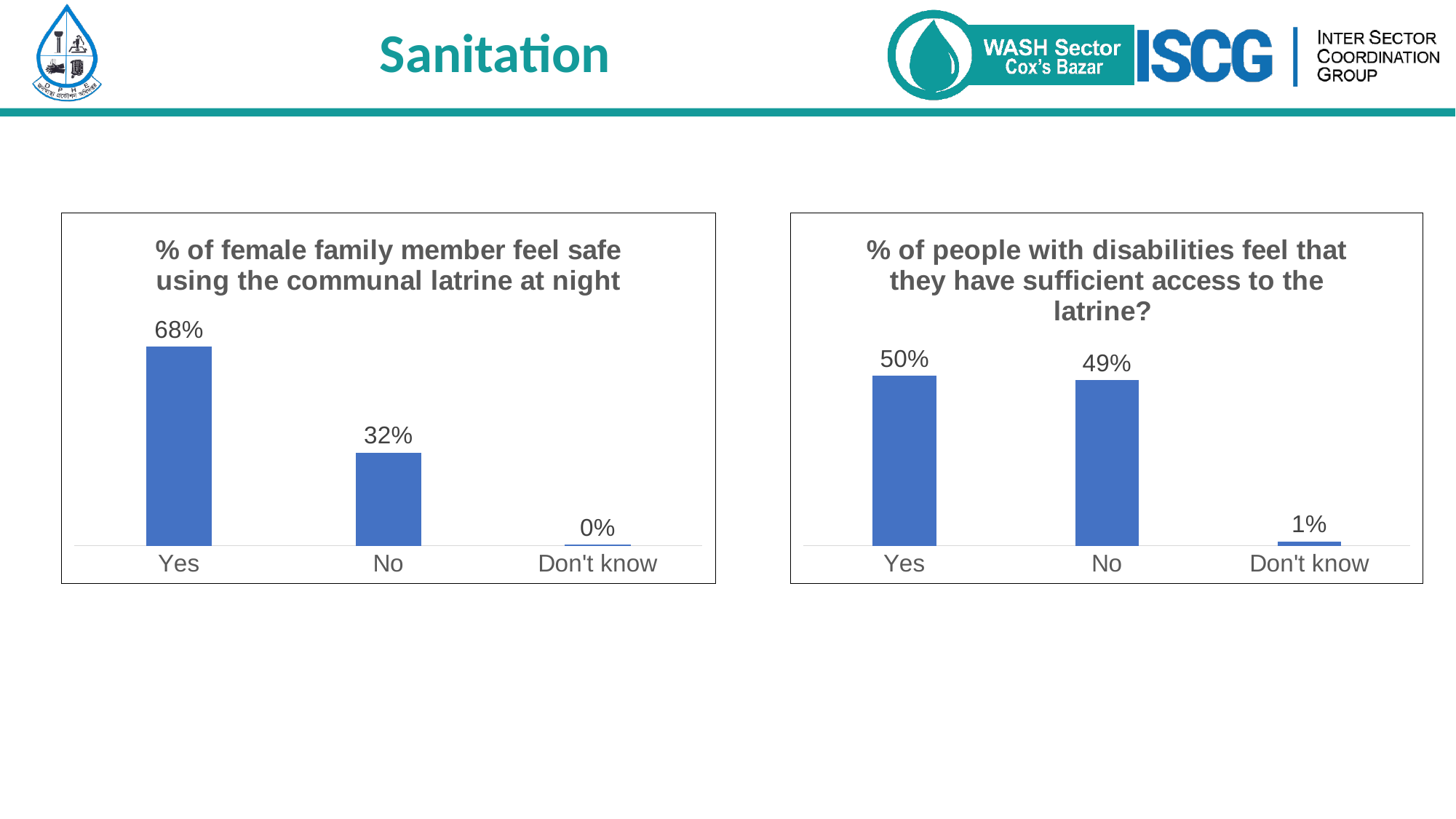
What type of chart is the left chart (% of female family member feel safe using the communal latrine at night)? Bar chart What is the title of the right chart? % of people with disabilities feel that they have sufficient access to the latrine? In the left chart (% of female family member feel safe using the communal latrine at night), which category has the highest value? Yes In the right chart (% of people with disabilities feel that they have sufficient access to the latrine?), what is the difference between the Yes and No values? 1% In the left chart (% of female family member feel safe using the communal latrine at night), what is the value for No? 32% In the right chart (% of people with disabilities feel that they have sufficient access to the latrine?), which category has the lowest value? Don't know In the left chart (% of female family member feel safe using the communal latrine at night), what is the value for Don't know? 0% In the left chart (% of female family member feel safe using the communal latrine at night), what is the difference between the Yes and No values? 36% How many categories are shown in the right chart (% of people with disabilities feel that they have sufficient access to the latrine?)? 3 In the left chart (% of female family member feel safe using the communal latrine at night), what is the value for Yes? 68% In the right chart (% of people with disabilities feel that they have sufficient access to the latrine?), what is the value for Yes? 50% In the right chart (% of people with disabilities feel that they have sufficient access to the latrine?), what is the value for Don't know? 1%